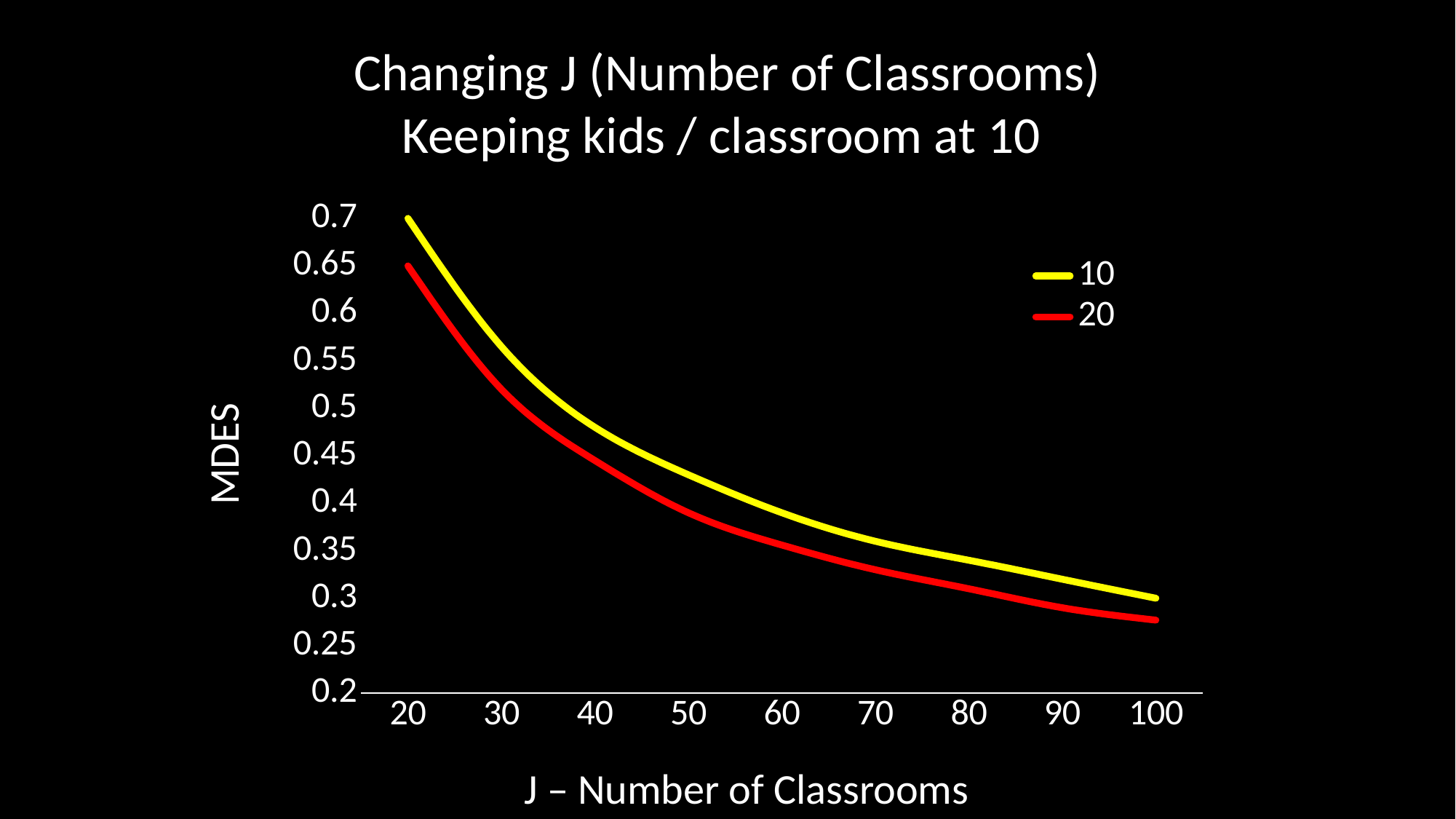
Is the MDES for series 10 at J = 50 greater or less than 0.4? greater Is the MDES for series 20 at J = 100 greater or less than 0.3? less How many series does the legend list? 2 What is the label of the x axis? J – Number of Classrooms How many tick values are labelled on the x axis? 9 Is the MDES for series 20 at J = 60 greater or less than 0.4? less At J = 50, which series has the higher MDES, 10 or 20? 10 Do the MDES values rise or fall as J increases along the x axis? fall Which series is drawn in yellow? 10 What kind of chart is shown on the slide? line chart